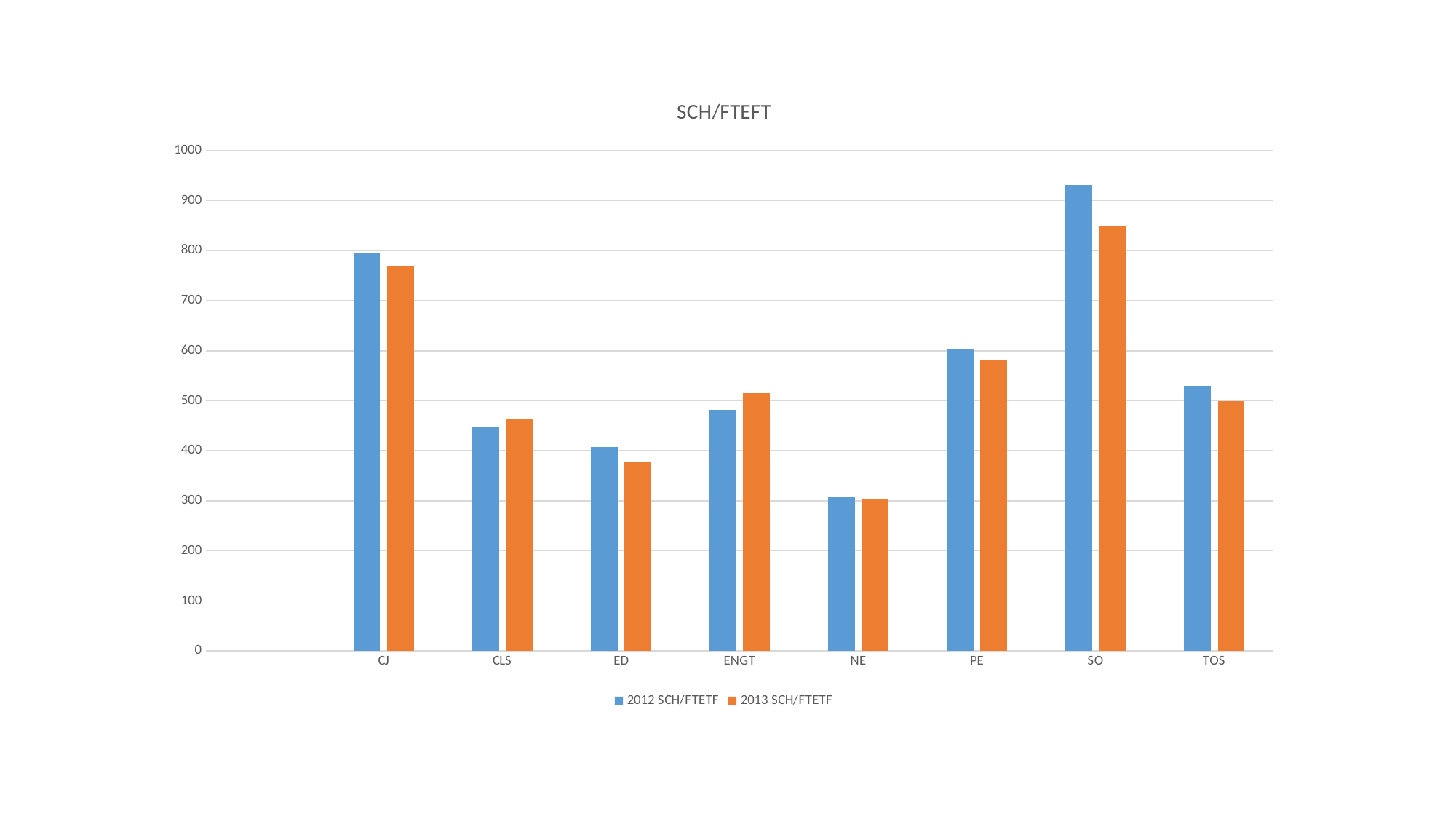
How many series does the legend list? 2 Is the 2013 SCH/FTETF value for PE greater or less than 600? less Is the 2012 SCH/FTETF value for CLS greater or less than 500? less Is the 2012 SCH/FTETF value for SO greater or less than 900? greater What is the title of the chart? SCH/FTEFT For SO, which is larger: the 2012 SCH/FTETF value or the 2013 SCH/FTETF value? 2012 SCH/FTETF How many categories are shown on the x axis? 8 Which category has the lowest 2013 SCH/FTETF value? NE Which category has the highest 2012 SCH/FTETF value? SO What kind of chart is shown on the slide? bar chart For ENGT, which is larger: the 2012 SCH/FTETF value or the 2013 SCH/FTETF value? 2013 SCH/FTETF